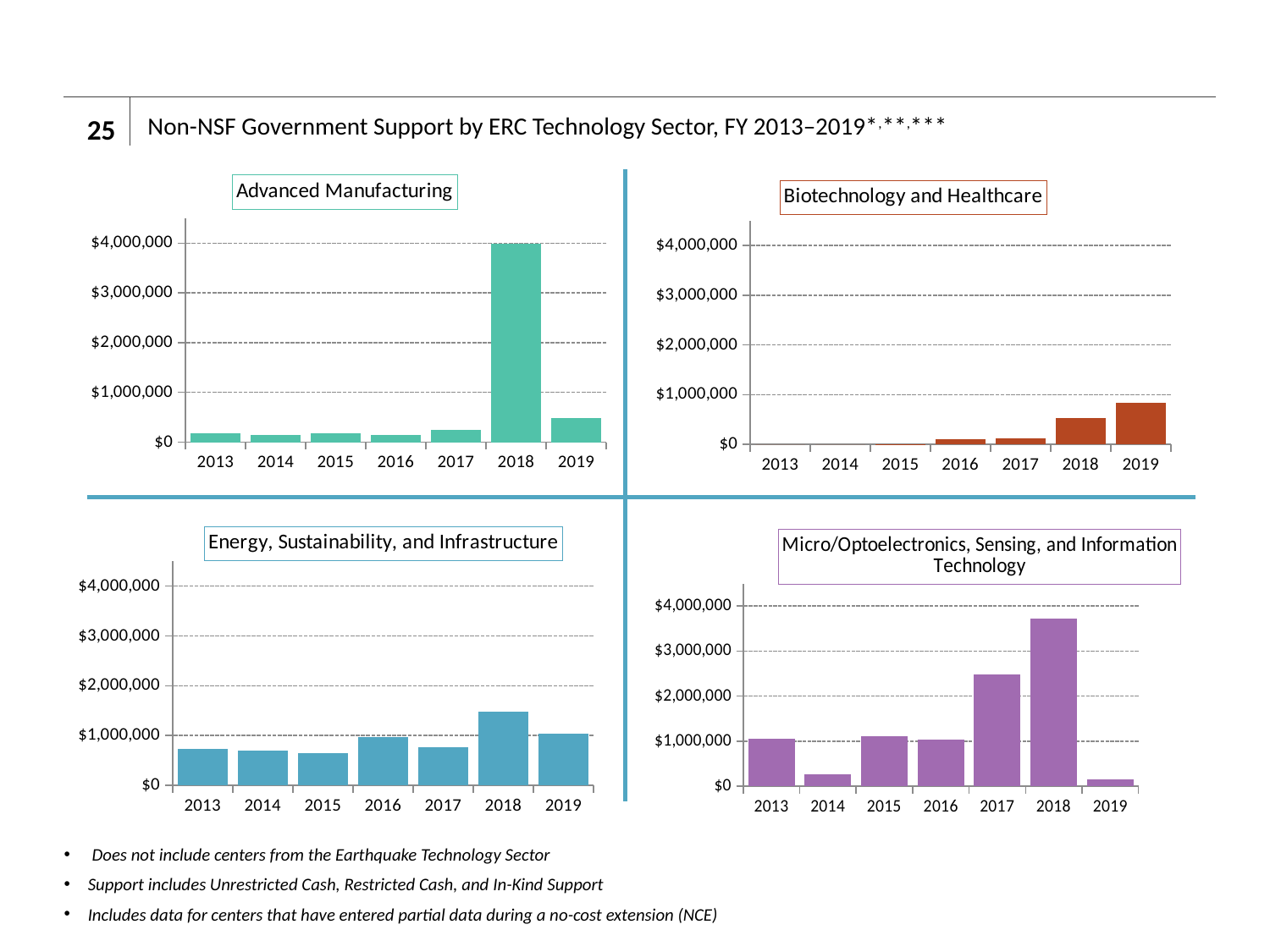
In the Micro/Optoelectronics, Sensing, and Information Technology chart, is the value for 2017 greater or less than $2,000,000? greater In the Micro/Optoelectronics, Sensing, and Information Technology chart, which year has the lowest value? 2019 In the Energy, Sustainability, and Infrastructure chart, which is larger, the value for 2016 or the value for 2017? 2016 In the Advanced Manufacturing chart, is the value for 2018 greater or less than $3,000,000? greater In the Micro/Optoelectronics, Sensing, and Information Technology chart, which year has the highest value? 2018 In the Energy, Sustainability, and Infrastructure chart, which year has the highest value? 2018 In the Biotechnology and Healthcare chart, which year has the highest value? 2019 How many years are shown on the x axis of the Energy, Sustainability, and Infrastructure chart? 7 In the Biotechnology and Healthcare chart, is the value for 2019 greater or less than $1,000,000? less What kind of chart is the Biotechnology and Healthcare chart? bar chart